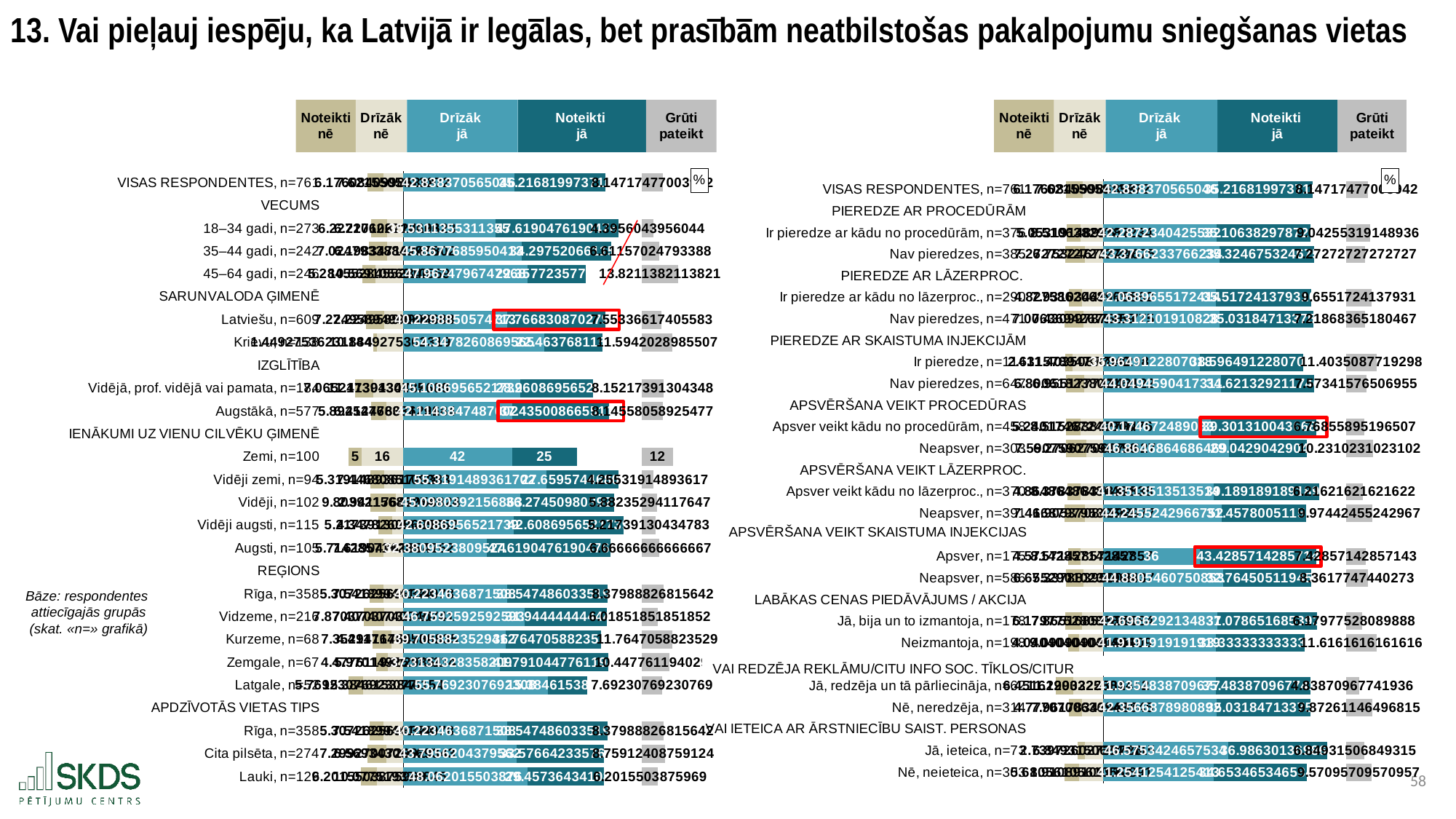
On the left chart, what is the difference between 'Drīzāk jā' and 'Noteikti jā' in the 'Zemi, n=100' row? 17 How many series does the legend of the left chart list? 5 On the left chart, what is the value for 'Noteikti jā' in the 'Zemi, n=100' row? 25 On the left chart, what is the value for 'Grūti pateikt' in the 'Zemi, n=100' row? 12 On the left chart, what is the value for 'Drīzāk nē' in the 'Zemi, n=100' row? 16 On the left chart, what is the total of the stacked bar for 'Zemi, n=100'? 100 On the left chart, in the 'Zemi, n=100' row, which is larger: 'Drīzāk nē' or 'Grūti pateikt'? Drīzāk nē On the left chart, which answer category has the lowest value in the 'Zemi, n=100' row? Noteikti nē On the left chart, how many bars (respondent groups) are plotted? 21 What kind of chart is shown on the right side of the slide? Stacked bar chart On the left chart, which answer category has the highest value in the 'Zemi, n=100' row? Drīzāk jā On the left chart, what is the value for 'Drīzāk jā' in the 'Zemi, n=100' row? 42